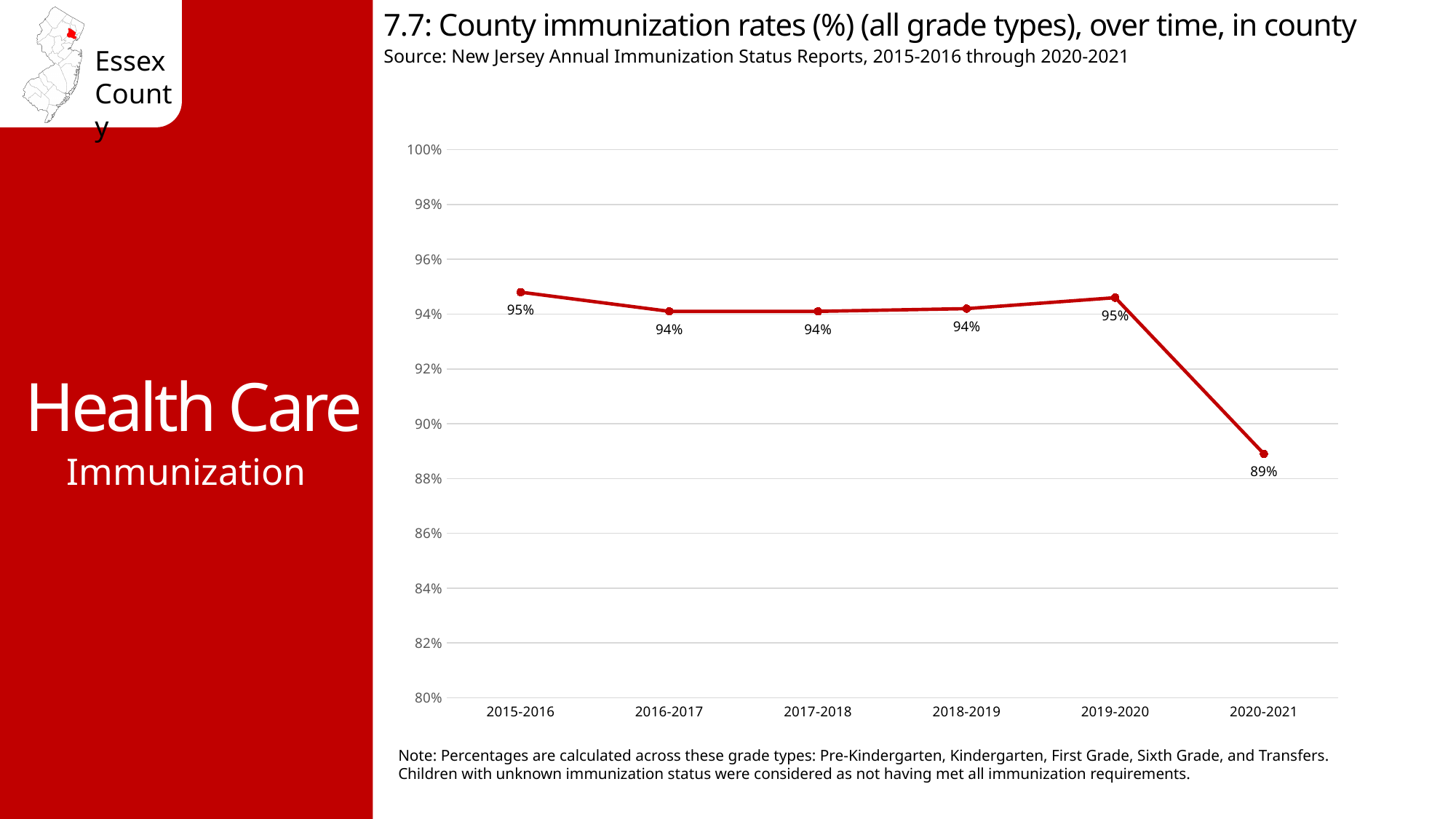
What is the county immunization rate for 2019-2020? 95% What is the county immunization rate for 2017-2018? 94% Which is larger, the immunization rate in 2015-2016 or in 2020-2021? 2015-2016 What kind of chart is shown on the slide? Line chart What is the difference between the immunization rate in 2019-2020 and in 2020-2021? 6% What is the county immunization rate for 2015-2016? 95% Is the immunization rate for 2020-2021 greater or less than 90%? less Which school year has the lowest immunization rate? 2020-2021 What is the county immunization rate for 2020-2021? 89% How many school years are plotted on the chart? 6 Does the immunization rate rise or fall between 2019-2020 and 2020-2021? Fall Is the immunization rate for 2018-2019 greater or less than 92%? greater